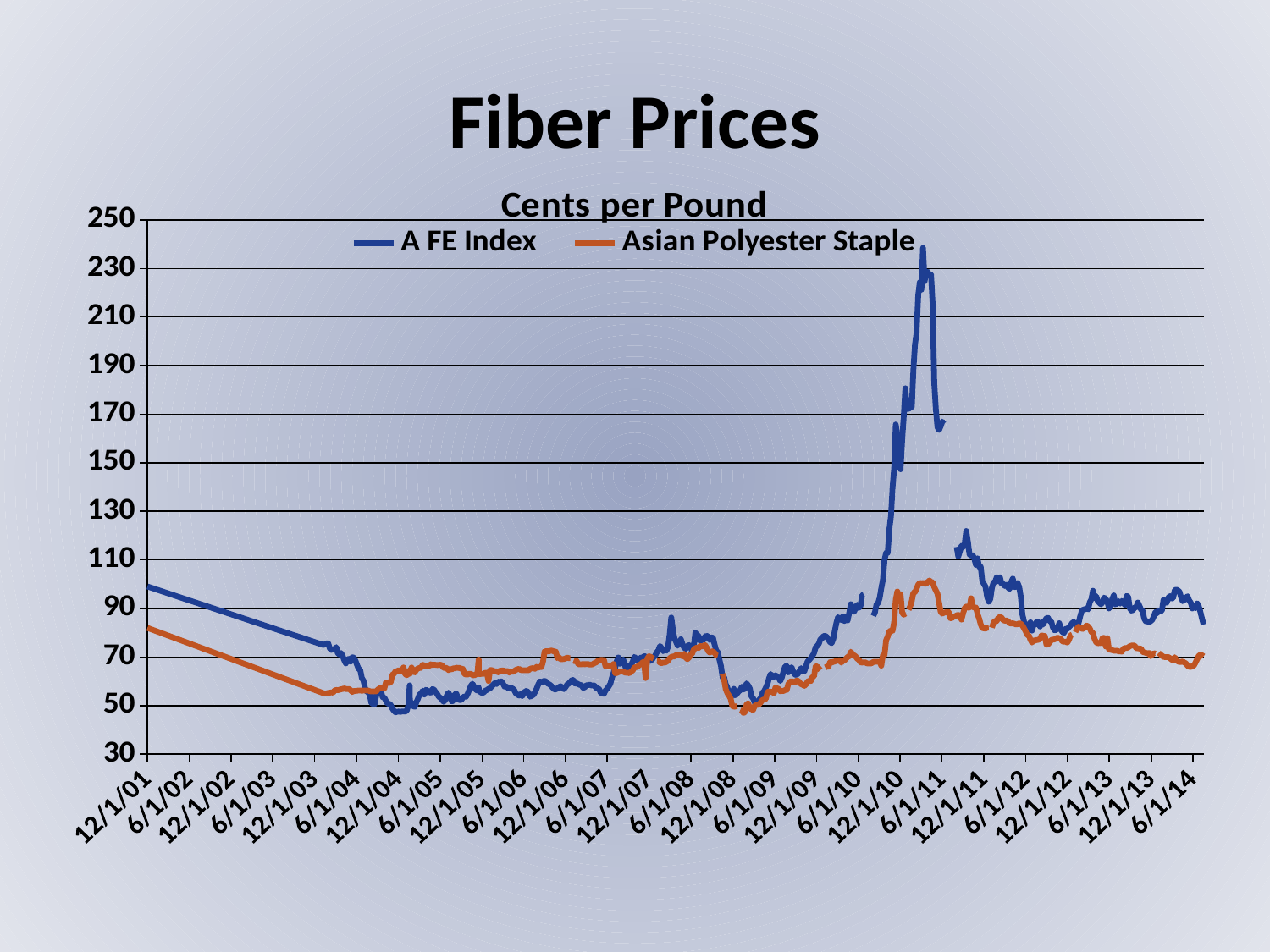
Is the peak value of the A FE Index in 2011 greater or less than 210? greater At 12/1/01, which series has the higher value, A FE Index or Asian Polyester Staple? A FE Index Is the value of Asian Polyester Staple at 12/1/01 greater or less than 70? greater Which series is drawn in orange? Asian Polyester Staple Is the value of the A FE Index at 12/1/01 greater or less than 90? greater Does the A FE Index rise or fall between 12/1/01 and 12/1/03? fall What is the title shown above the chart's plot area? Cents per Pound How many series does the chart legend list? 2 Which series reaches the higher peak in 2011, A FE Index or Asian Polyester Staple? A FE Index What kind of chart is shown on the slide? line chart